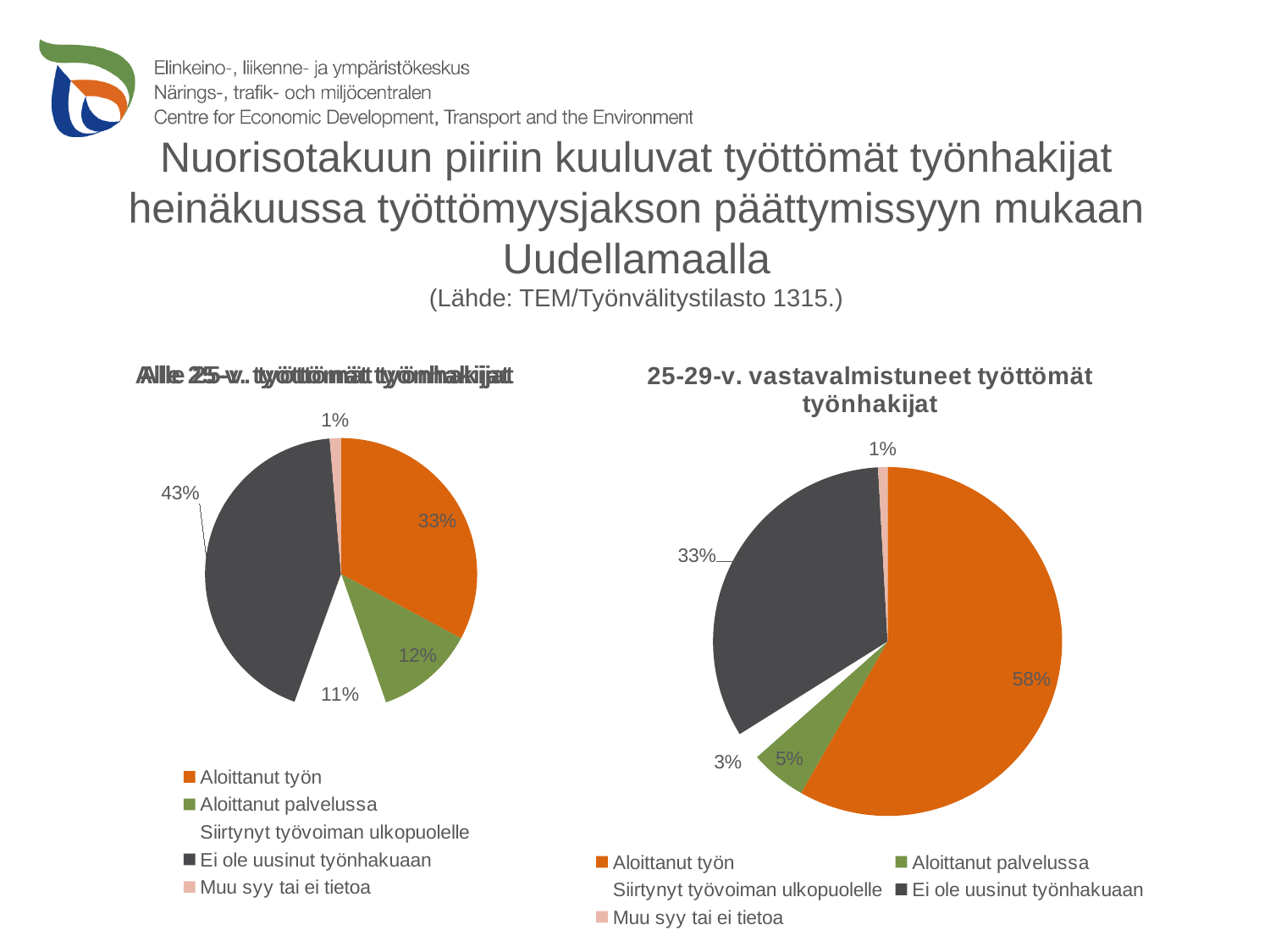
In the left chart (Alle 25-v. työttömät työnhakijat), what is the difference between the Ei ole uusinut työnhakuaan share and the Aloittanut työn share? 10% In the chart titled '25-29-v. vastavalmistuneet työttömät työnhakijat', which category has the largest slice? Aloittanut työn In the left chart (Alle 25-v. työttömät työnhakijat), which category has the smallest slice? Muu syy tai ei tietoa How many categories does the legend of the chart titled '25-29-v. vastavalmistuneet työttömät työnhakijat' list? 5 In the left chart (Alle 25-v. työttömät työnhakijat), what share is labelled for Aloittanut työn? 33% In the chart titled '25-29-v. vastavalmistuneet työttömät työnhakijat', what share is labelled for Aloittanut palvelussa? 5% In the chart titled '25-29-v. vastavalmistuneet työttömät työnhakijat', what colour is the Aloittanut työn slice? orange In the left chart (Alle 25-v. työttömät työnhakijat), which category has the largest slice? Ei ole uusinut työnhakuaan In the chart titled '25-29-v. vastavalmistuneet työttömät työnhakijat', which is larger: Aloittanut palvelussa or Siirtynyt työvoiman ulkopuolelle? Aloittanut palvelussa In the left chart (Alle 25-v. työttömät työnhakijat), what share is labelled for Ei ole uusinut työnhakuaan? 43% What kind of chart is the left chart on the slide? pie chart In the chart titled '25-29-v. vastavalmistuneet työttömät työnhakijat', what share is labelled for Aloittanut työn? 58%